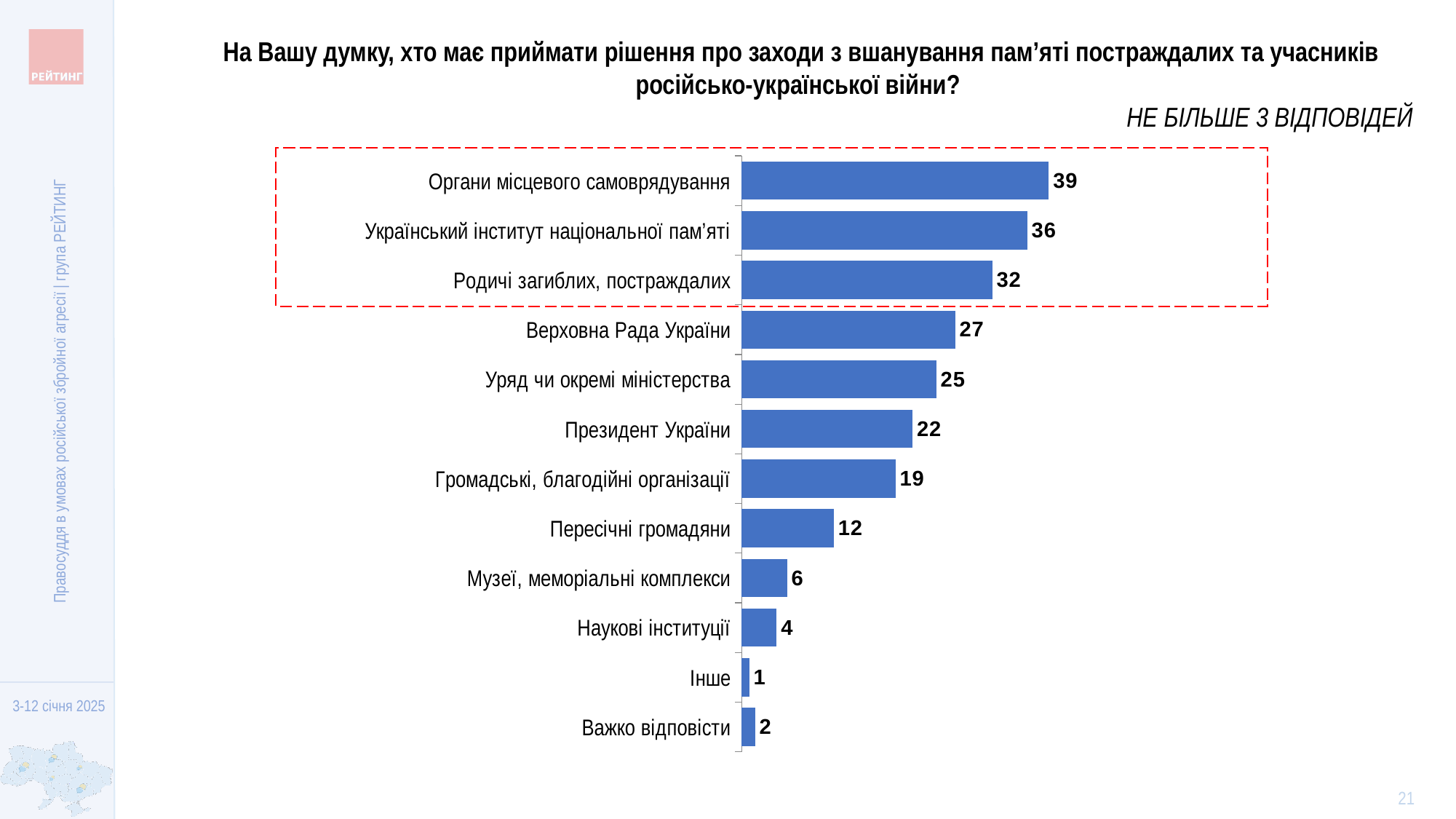
What value is shown for Органи місцевого самоврядування? 39 Which category has the highest value? Органи місцевого самоврядування How many categories are enclosed in the red dashed box? 3 How many categories are shown in the chart? 12 Which category has the lowest value? Інше What is the difference between the values for Український інститут національної пам'яті and Верховна Рада України? 9 What kind of chart is shown on the slide? Bar chart What value is shown for Родичі загиблих, постраждалих? 32 What is the difference between the values for Музеї, меморіальні комплекси and Наукові інституції? 2 Which is larger: the value for Президент України or the value for Уряд чи окремі міністерства? Уряд чи окремі міністерства What value is shown for Пересічні громадяни? 12 What value is shown for Важко відповісти? 2